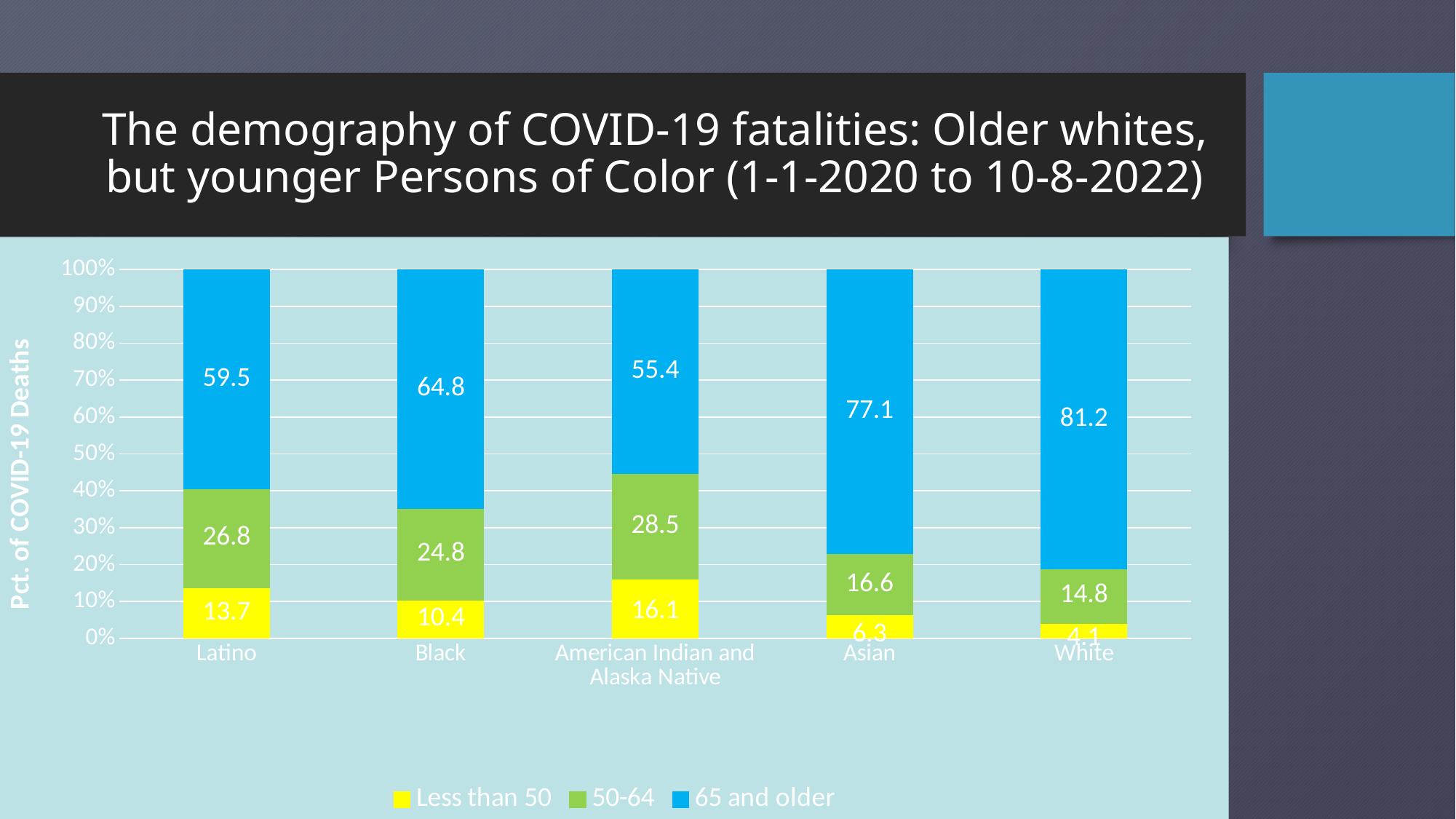
How many categories are shown on the x axis? 5 Which category has the highest value for the 65 and older series? White What is the value for the 50-64 series for American Indian and Alaska Native? 28.5 What kind of chart is shown on the slide? Stacked bar chart What is the value for the Less than 50 series for Latino? 13.7 What is the difference between the 65 and older values for White and Latino? 21.7 Which is larger, the Less than 50 value for Black or for Asian? Black Which category has the lowest value for the Less than 50 series? White What is the value for the 65 and older series for White? 81.2 What is the label of the y axis? Pct. of COVID-19 Deaths Which category has the highest value for the 50-64 series? American Indian and Alaska Native How many series does the legend list? 3